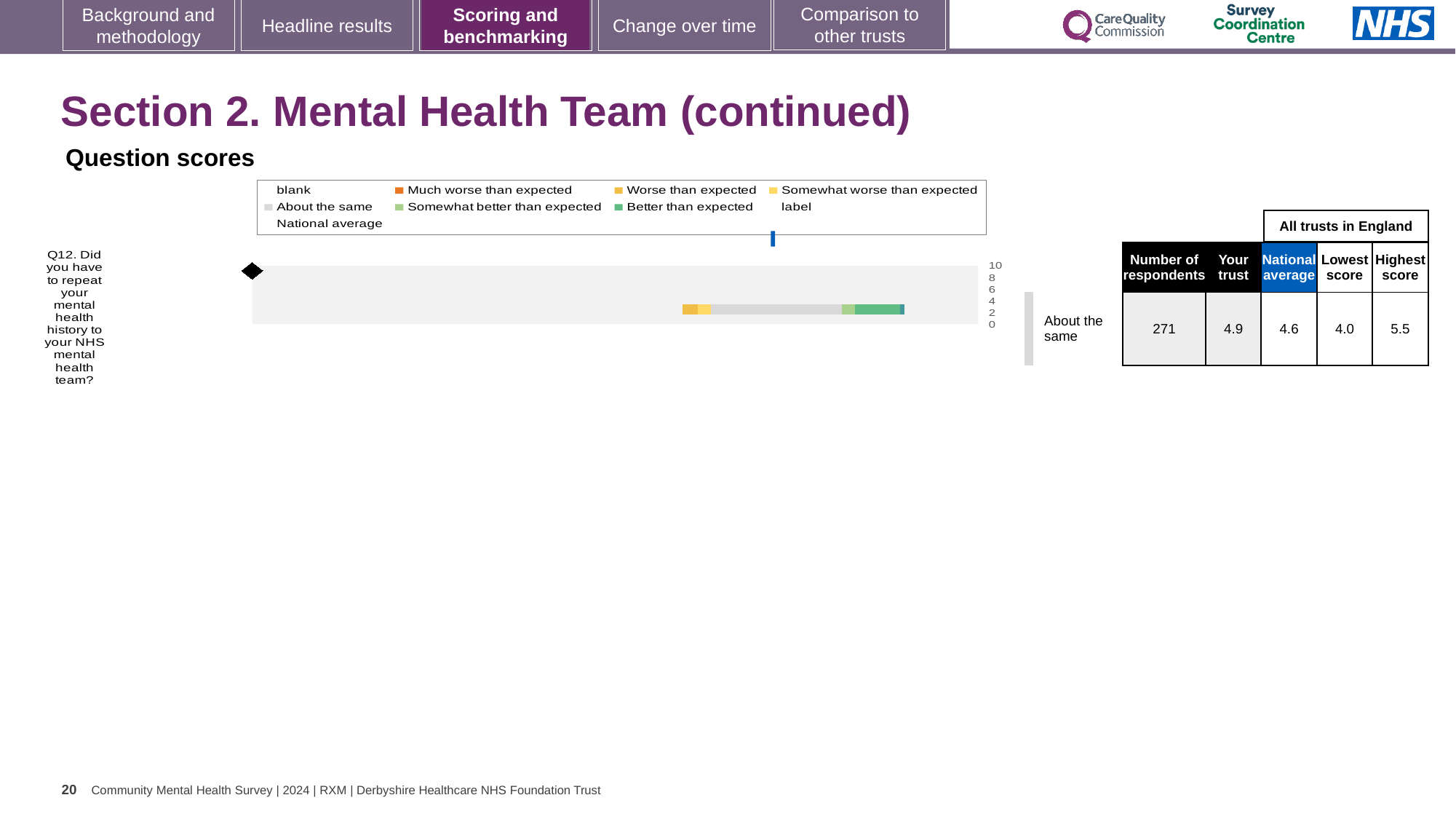
Which is larger for Q12, the 'Your trust' score or the national average? Your trust What is the national average score for Q12? 4.6 What is the lowest score among all trusts in England for Q12? 4.0 What is the difference between the 'Your trust' score and the national average for Q12? 0.3 What kind of chart is shown on the slide for Q12? bar chart How many survey questions are plotted on the chart? 1 What is the highest score among all trusts in England for Q12? 5.5 How many respondents answered Q12? 271 What is the difference between the highest score and the lowest score for Q12? 1.5 Which question is plotted on the chart? Q12. Did you have to repeat your mental health history to your NHS mental health team? What benchmark category is shown for Q12 next to the chart? About the same What is the 'Your trust' score for Q12? 4.9